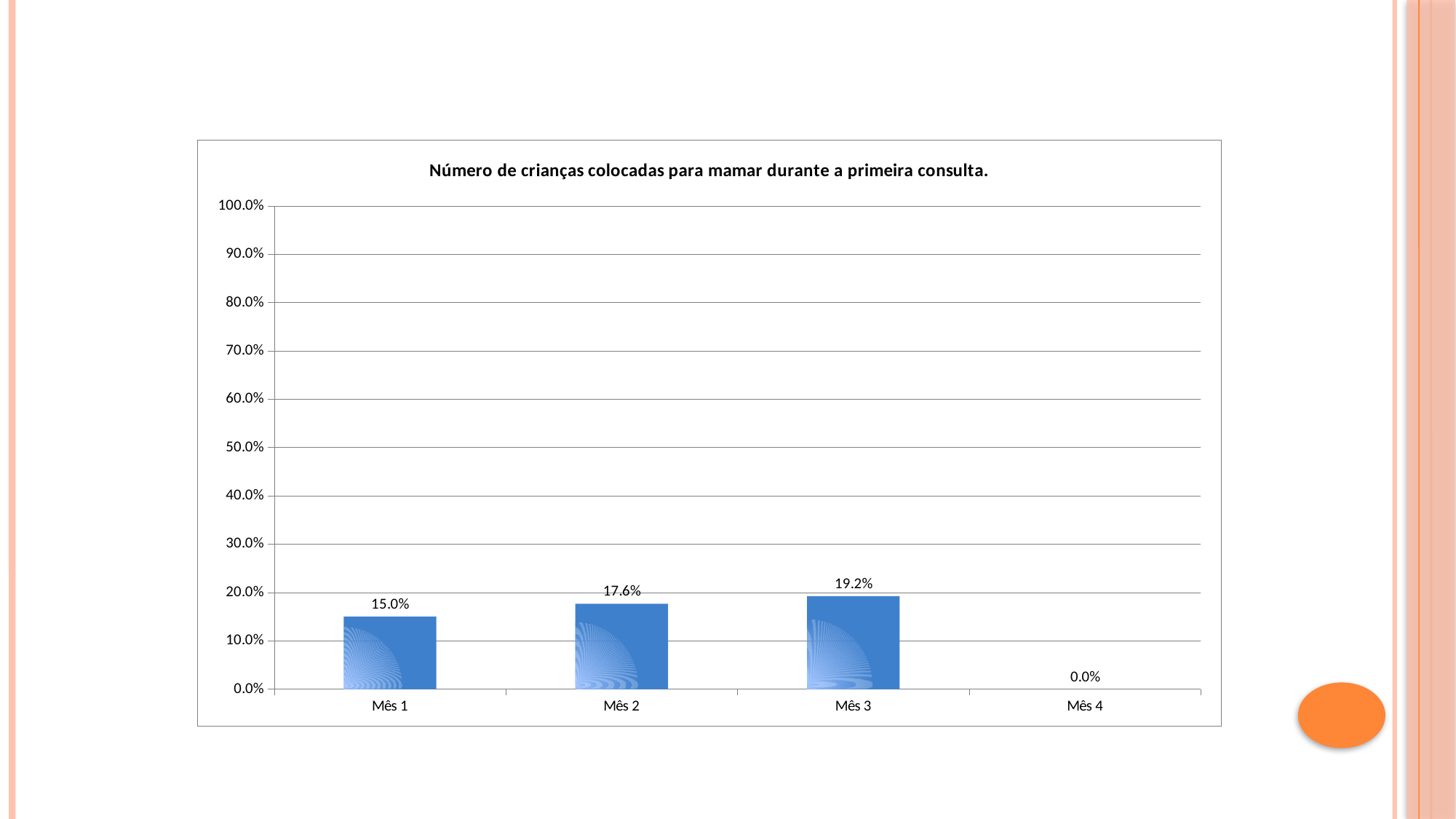
Which month has the highest value? Mês 3 Is the value for Mês 3 greater or less than 20.0%? less Which is larger, the value for Mês 2 or the value for Mês 1? Mês 2 What is the difference between the values for Mês 3 and Mês 1? 4.2% What is the value for Mês 3? 19.2% What kind of chart is shown on the slide? bar chart How many categories are shown on the x axis? 4 What is the value for Mês 1? 15.0% What is the value for Mês 4? 0.0% What is the title of the chart? Número de crianças colocadas para mamar durante a primeira consulta. Which month has the lowest value? Mês 4 What is the value for Mês 2? 17.6%